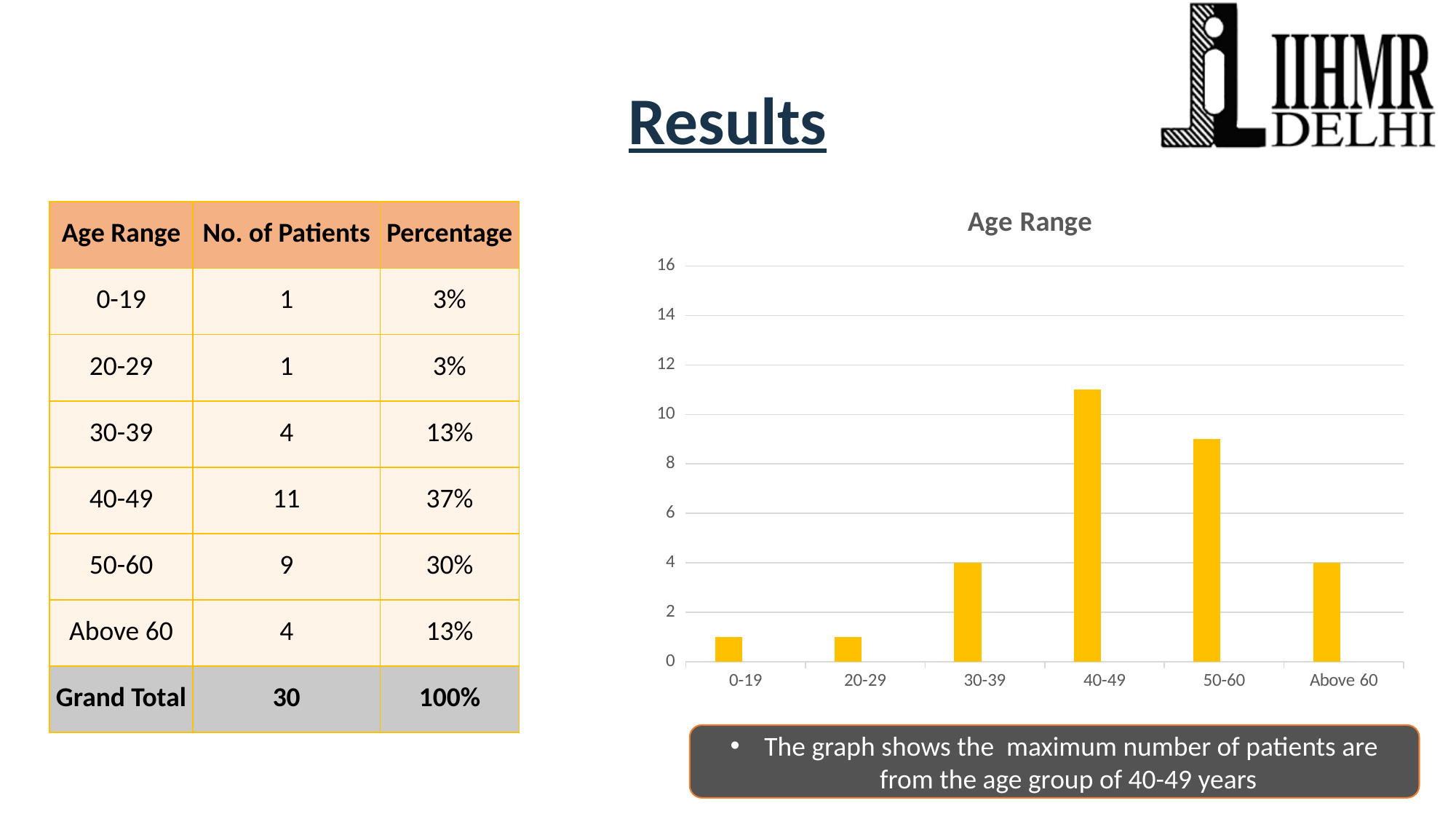
What type of chart is shown on the slide? bar chart What is the number of patients for the 50-60 age range? 9 What is the number of patients for the 40-49 age range? 11 What is the title of the chart? Age Range How many age-range categories are plotted in the chart? 6 What is the number of patients for the 30-39 age range? 4 Is the value for the 40-49 age range greater or less than 10? greater Which age range has the highest bar in the chart? 40-49 Which has more patients, the 30-39 age range or the 50-60 age range? 50-60 What is the difference in number of patients between the 40-49 and 50-60 age ranges? 2 Is the value for the Above 60 age range greater or less than 6? less What is the number of patients for the 0-19 age range? 1